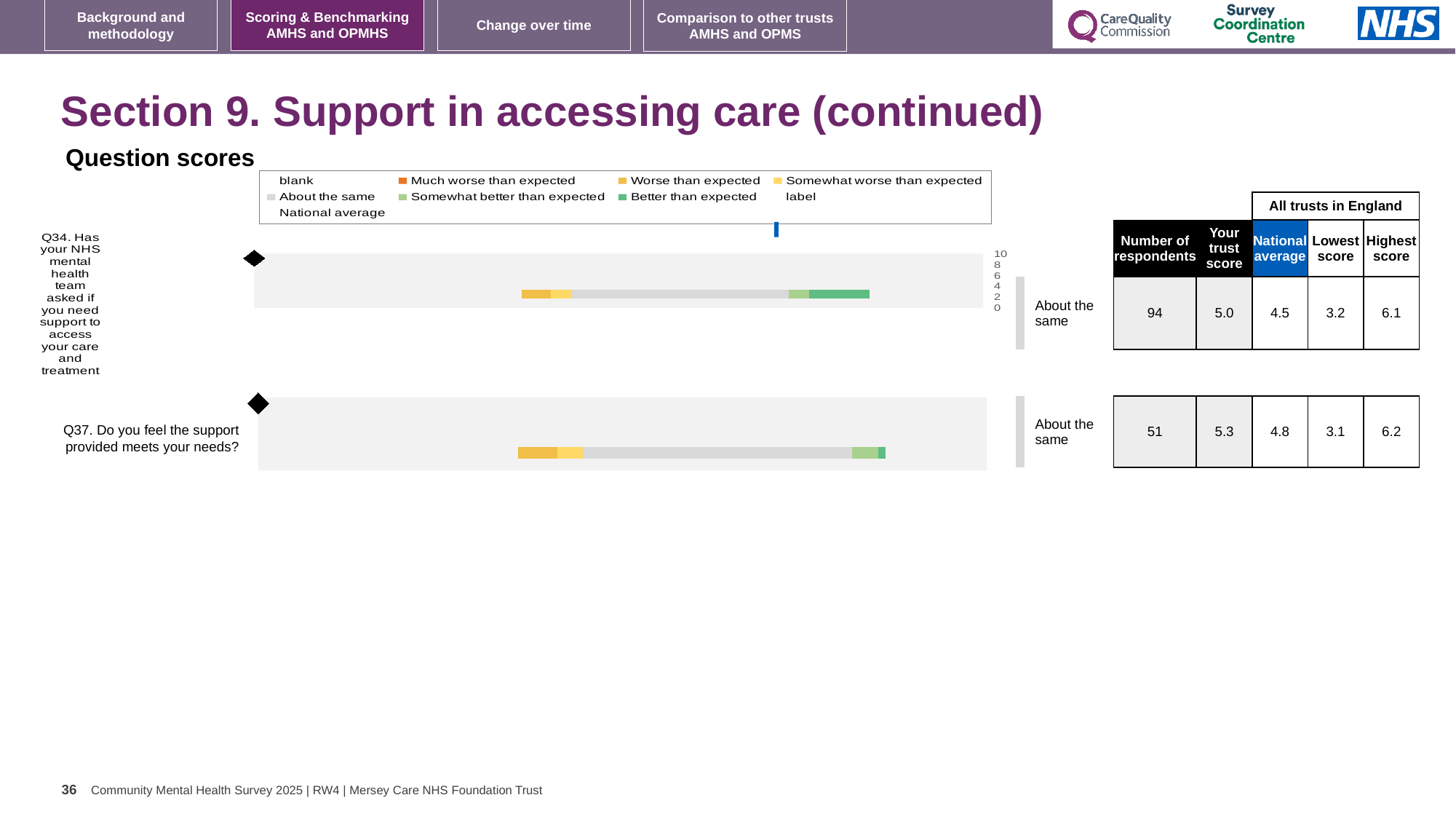
What kind of chart is used to show the question scores on this slide? bar chart How many questions are plotted in the question scores chart? 2 Which benchmark category is shown for Q37 in the question scores chart? About the same What is the national average score for Q34? 4.5 What is the difference between the trust scores for Q37 and Q34? 0.3 How many entries does the legend of the question scores chart list? 9 What is the trust score for Q34 (Has your NHS mental health team asked if you need support to access your care and treatment)? 5.0 Which benchmark category is shown for Q34 in the question scores chart? About the same How many respondents answered Q37? 51 What is the highest score among all trusts in England for Q37? 6.2 Which question has the higher trust score, Q34 or Q37? Q37 What is the trust score for Q37 (Do you feel the support provided meets your needs)? 5.3